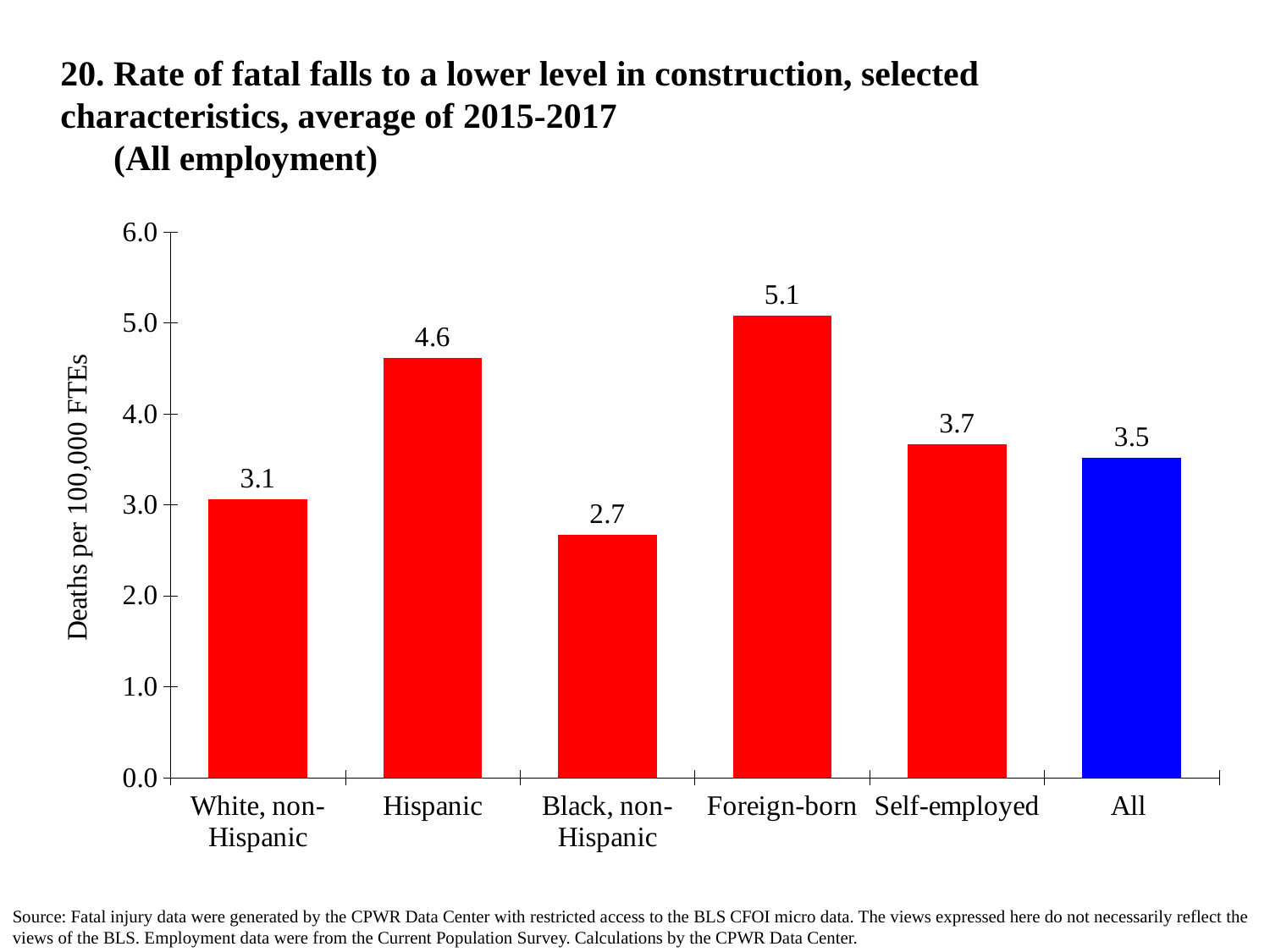
How many categories are shown on the x axis? 6 What kind of chart is shown on the slide? Bar chart Which category has the lowest rate of fatal falls? Black, non-Hispanic What is the rate of fatal falls for Self-employed workers? 3.7 Which bar is coloured blue rather than red? All Which is larger, the rate for White, non-Hispanic workers or the rate for All workers? All What is the label of the y axis? Deaths per 100,000 FTEs What is the difference between the rates for Foreign-born and Black, non-Hispanic workers? 2.4 What is the rate of fatal falls for Foreign-born workers? 5.1 What is the rate of fatal falls for Hispanic workers? 4.6 Which category has the highest rate of fatal falls? Foreign-born Is the value for Hispanic workers greater or less than 4.0? greater